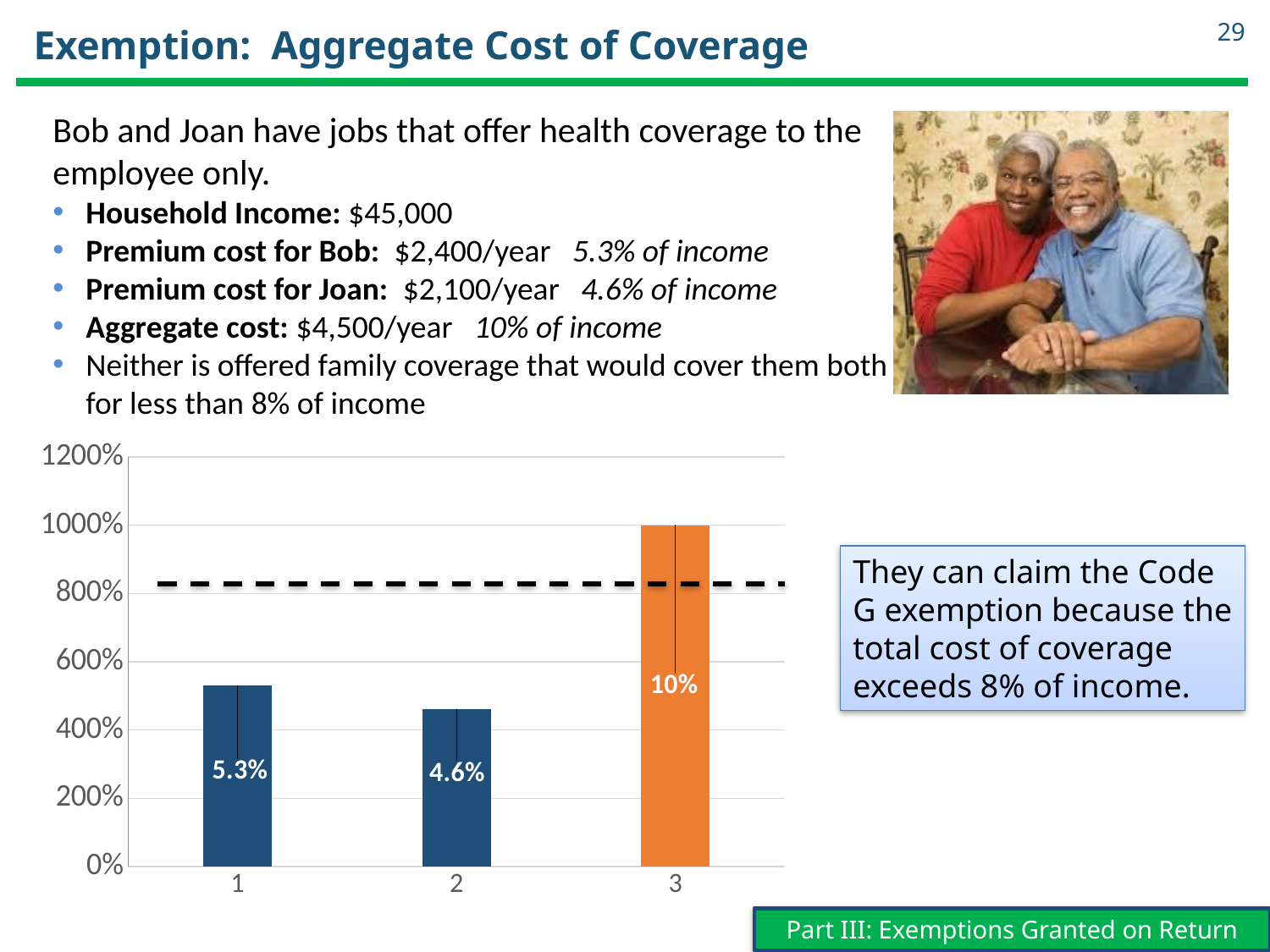
What colour is the bar for category 3? orange What is the difference between the labelled values for category 1 and category 2? 0.7% Which bar is taller, category 1 or category 2? 1 How many bars are plotted in the chart? 3 What is the data label on the bar for category 3? 10% What is the data label on the bar for category 2? 4.6% What type of chart is shown on the slide? bar chart What is the data label on the bar for category 1? 5.3% Which category has the tallest bar? 3 What is the difference between the labelled values for category 3 and category 1? 4.7% Which category has the shortest bar? 2 Is the bar for category 3 greater or less than the 800% gridline on the axis? greater